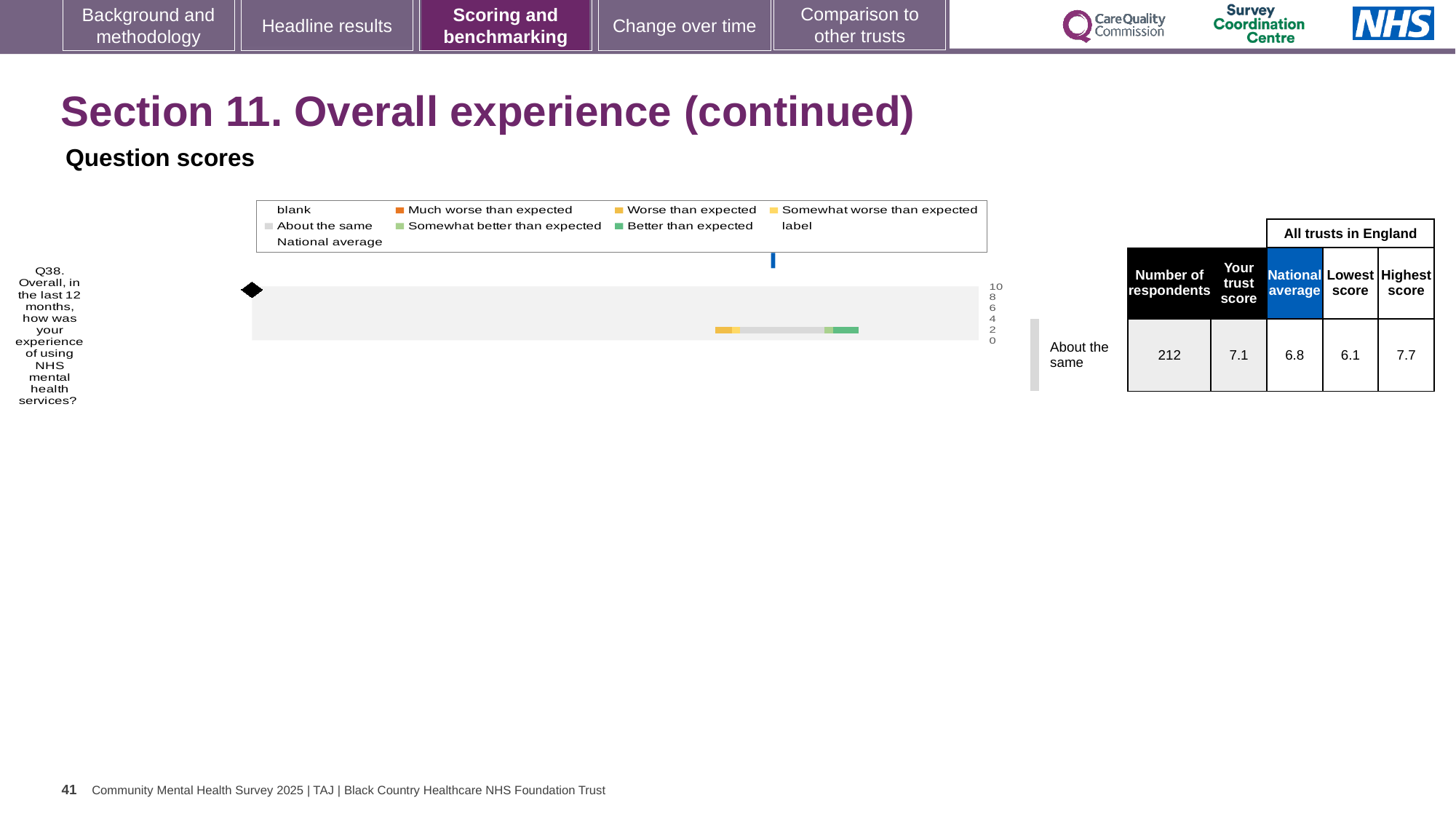
How many respondents answered Q38? 212 Which legend entry is shown in orange? Much worse than expected What is the difference between the trust's score and the national average for Q38? 0.3 What is the national average score for Q38? 6.8 What is the highest score among all trusts in England for Q38? 7.7 What kind of chart is used to show the Q38 question score? bar chart What is the trust's score for Q38 (Overall, in the last 12 months, how was your experience of using NHS mental health services?)? 7.1 Which is larger for Q38: the trust's score or the national average? the trust's score What is the difference between the highest and lowest scores among all trusts in England for Q38? 1.6 What is the highest value shown on the chart's score axis? 10 How many survey questions are plotted on the chart? 1 What is the lowest score among all trusts in England for Q38? 6.1